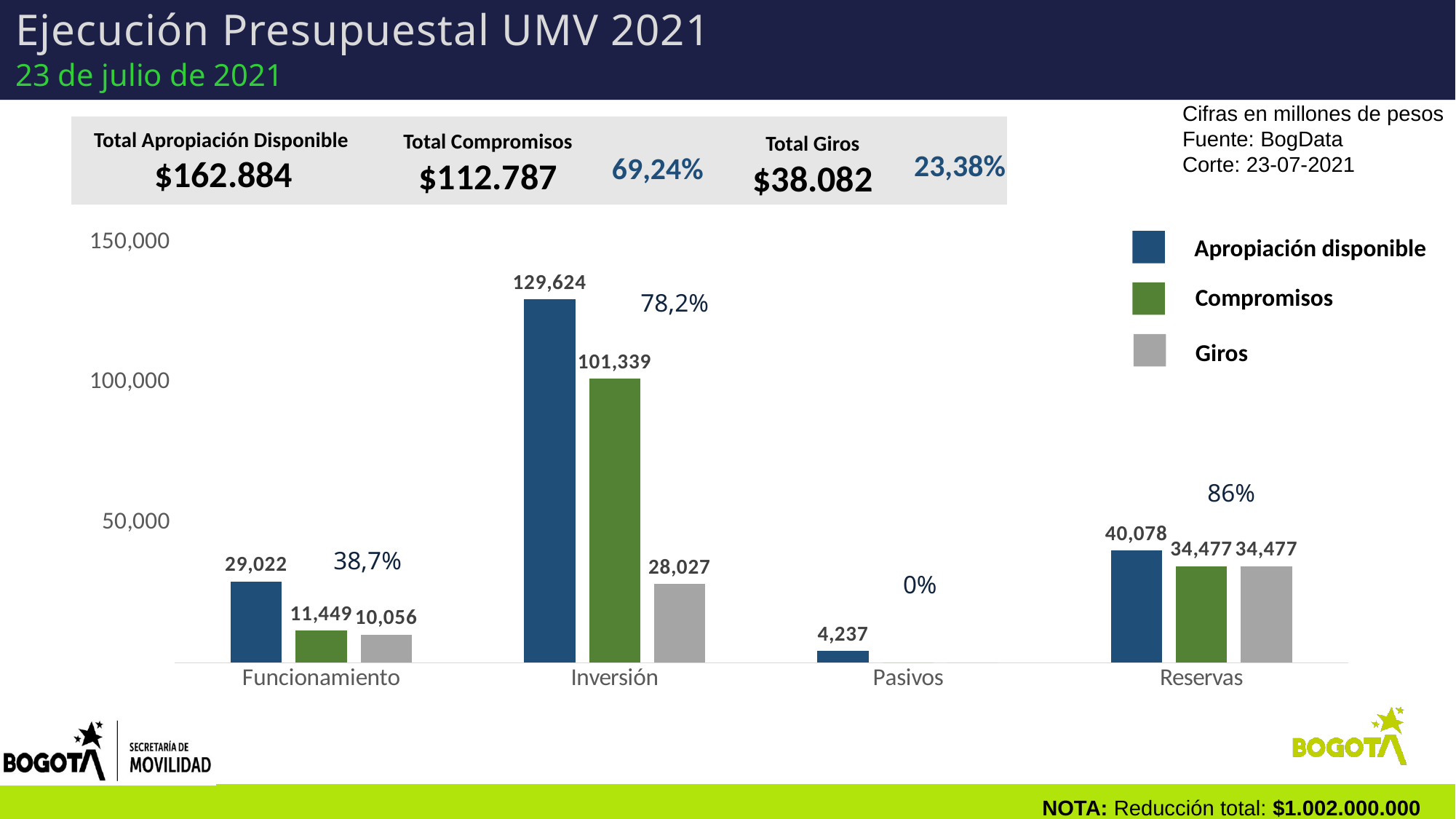
Which is larger, the Giros value for Inversión or the Giros value for Reservas? Reservas Is the Apropiación disponible value for Inversión greater or less than 100,000? greater What is the difference between Apropiación disponible and Compromisos for Reservas? 5,601 Which category has the highest Apropiación disponible value? Inversión What is the Apropiación disponible value for Inversión? 129,624 What is the Compromisos value for Funcionamiento? 11,449 How many categories are shown on the x axis of the chart? 4 Which category has the lowest Apropiación disponible value? Pasivos What is the Apropiación disponible value for Pasivos? 4,237 What is the Giros value for Reservas? 34,477 How many series does the legend list? 3 What is the difference between Apropiación disponible and Compromisos for Inversión? 28,285